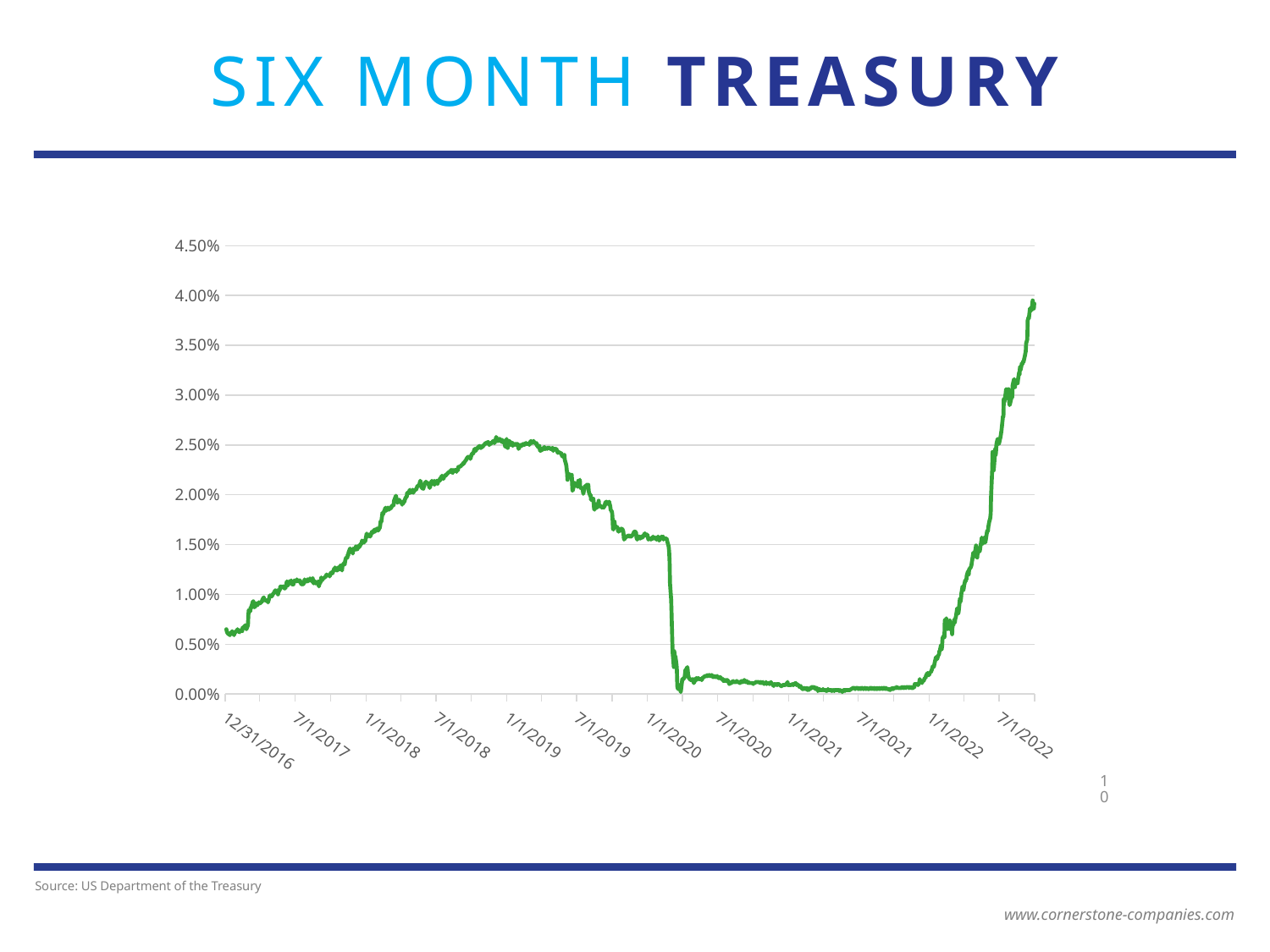
What kind of chart is shown on the slide? line chart Is the value at 12/31/2016 greater or less than 1.00%? less Is the value at 1/1/2019 greater or less than 2.00%? greater Which is larger, the value at 7/1/2018 or the value at 7/1/2020? 7/1/2018 Is the value at 1/1/2021 greater or less than 0.50%? less Does the line rise or fall between 12/31/2016 and 1/1/2019? rise How many date labels are shown along the x axis? 12 What source is cited for the chart data? US Department of the Treasury What is the title of the chart on the slide? SIX MONTH TREASURY Does the line rise or fall between 1/1/2022 and the end of the series? rise